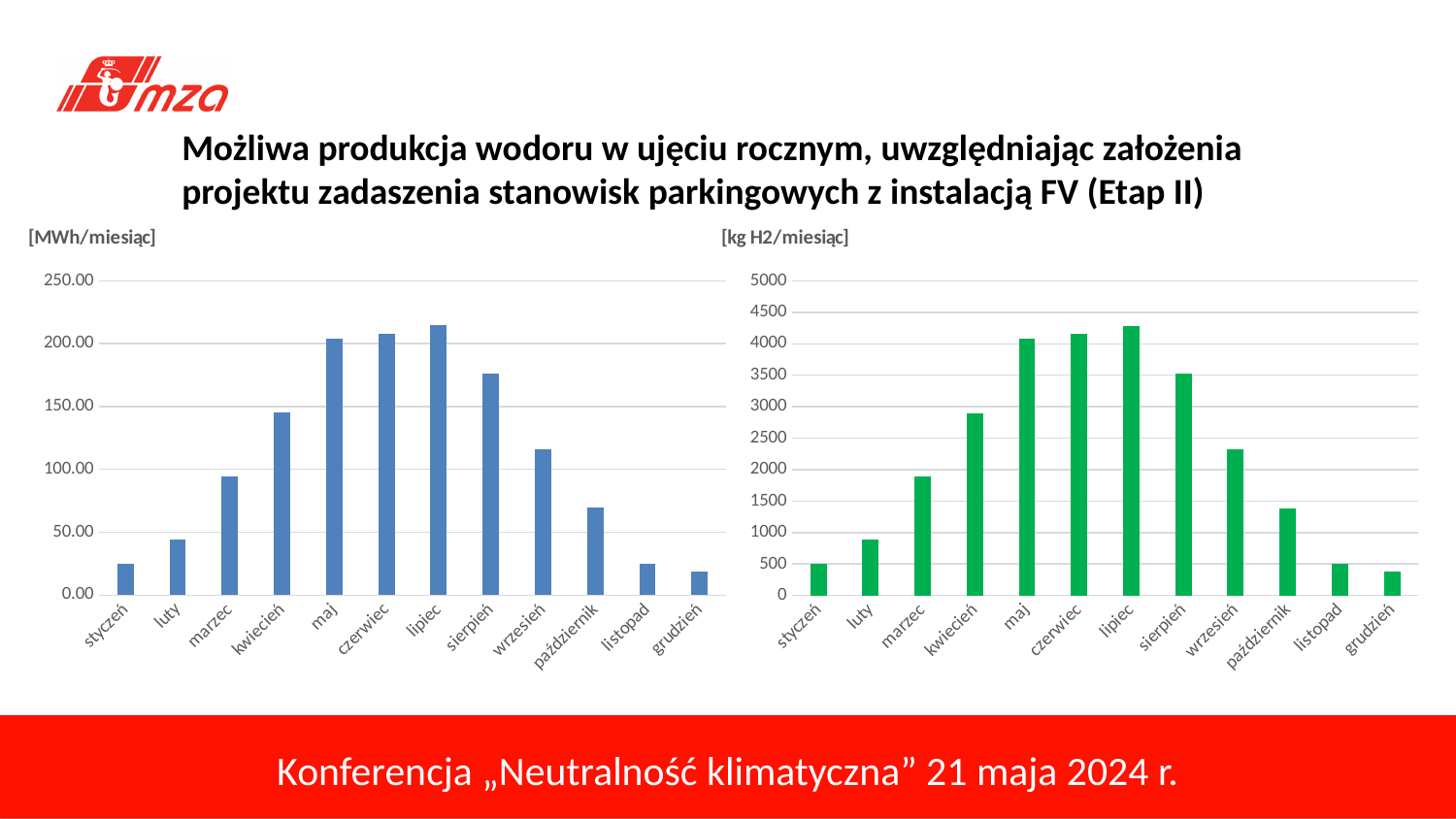
In the right chart [kg H2/miesiąc], is the value for wrzesień greater or less than 2000? greater What type of chart is the left chart labelled [MWh/miesiąc]? bar chart In the right chart [kg H2/miesiąc], is the value for kwiecień greater or less than 3000? less In the left chart [MWh/miesiąc], which month has the lowest value? grudzień In the right chart [kg H2/miesiąc], which month has the lowest value? grudzień In the left chart [MWh/miesiąc], which month has the highest value? lipiec In the left chart [MWh/miesiąc], is the value for styczeń greater or less than 50.00? less In the left chart [MWh/miesiąc], which is larger, the value for sierpień or the value for wrzesień? sierpień How many months are shown on the x axis of the right chart [kg H2/miesiąc]? 12 In the right chart [kg H2/miesiąc], do the values rise or fall from lipiec to grudzień? fall In the right chart [kg H2/miesiąc], which month has the highest value? lipiec